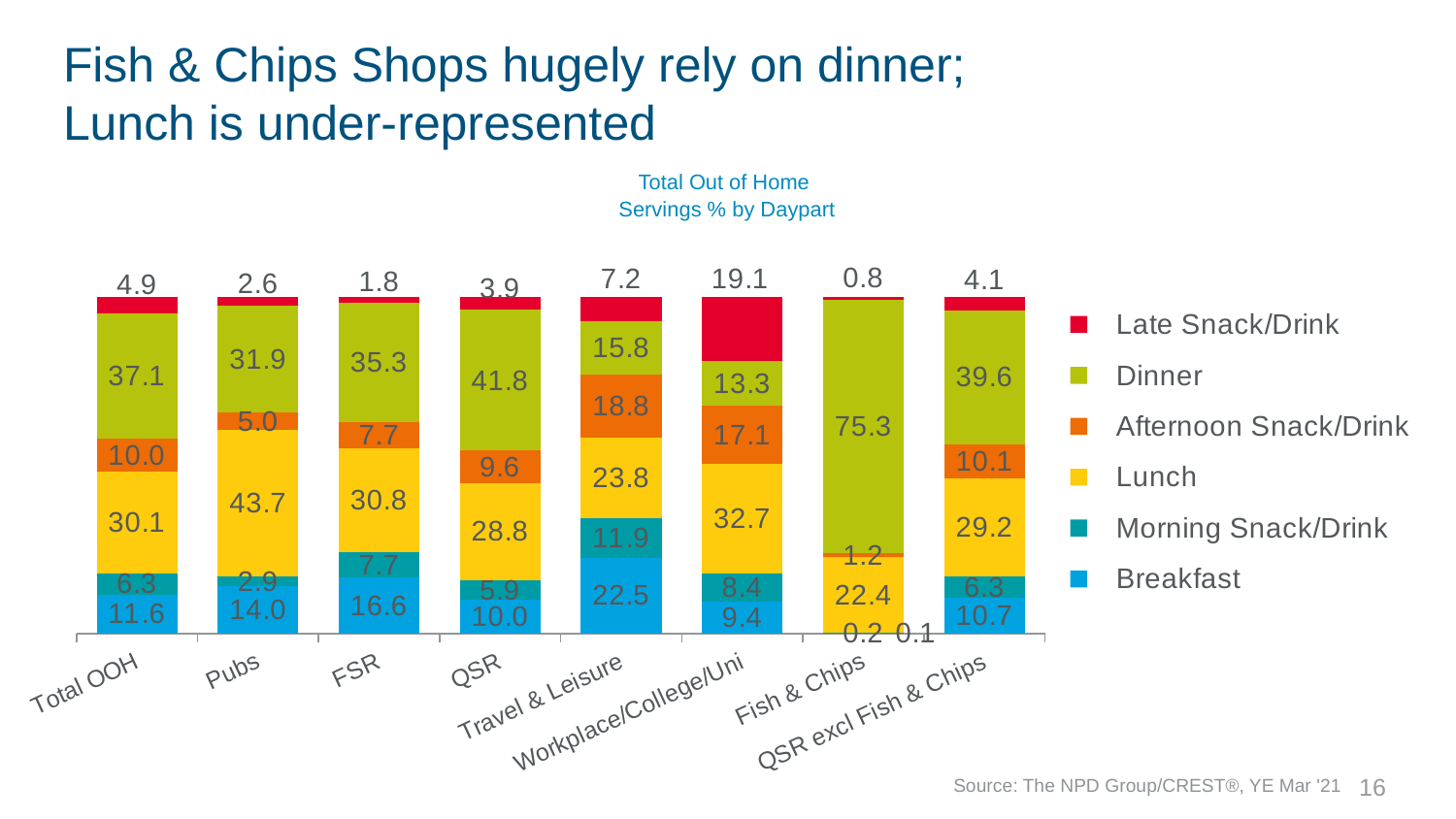
How many categories are shown on the x axis? 8 Which category has the lowest Late Snack/Drink value? Fish & Chips What kind of chart is shown on the slide? Stacked bar chart What is the Lunch value for Pubs? 43.7 What is the Dinner value for Fish & Chips? 75.3 What is the total of the stacked bar for Total OOH? 100.0 How many series does the legend list? 6 Which category has the highest Dinner value? Fish & Chips What is the Late Snack/Drink value for Workplace/College/Uni? 19.1 What is the difference between the Dinner value for Fish & Chips and the Dinner value for Total OOH? 38.2 Which is larger: the Lunch value for Pubs or the Lunch value for Fish & Chips? Pubs What is the Breakfast value for Travel & Leisure? 22.5